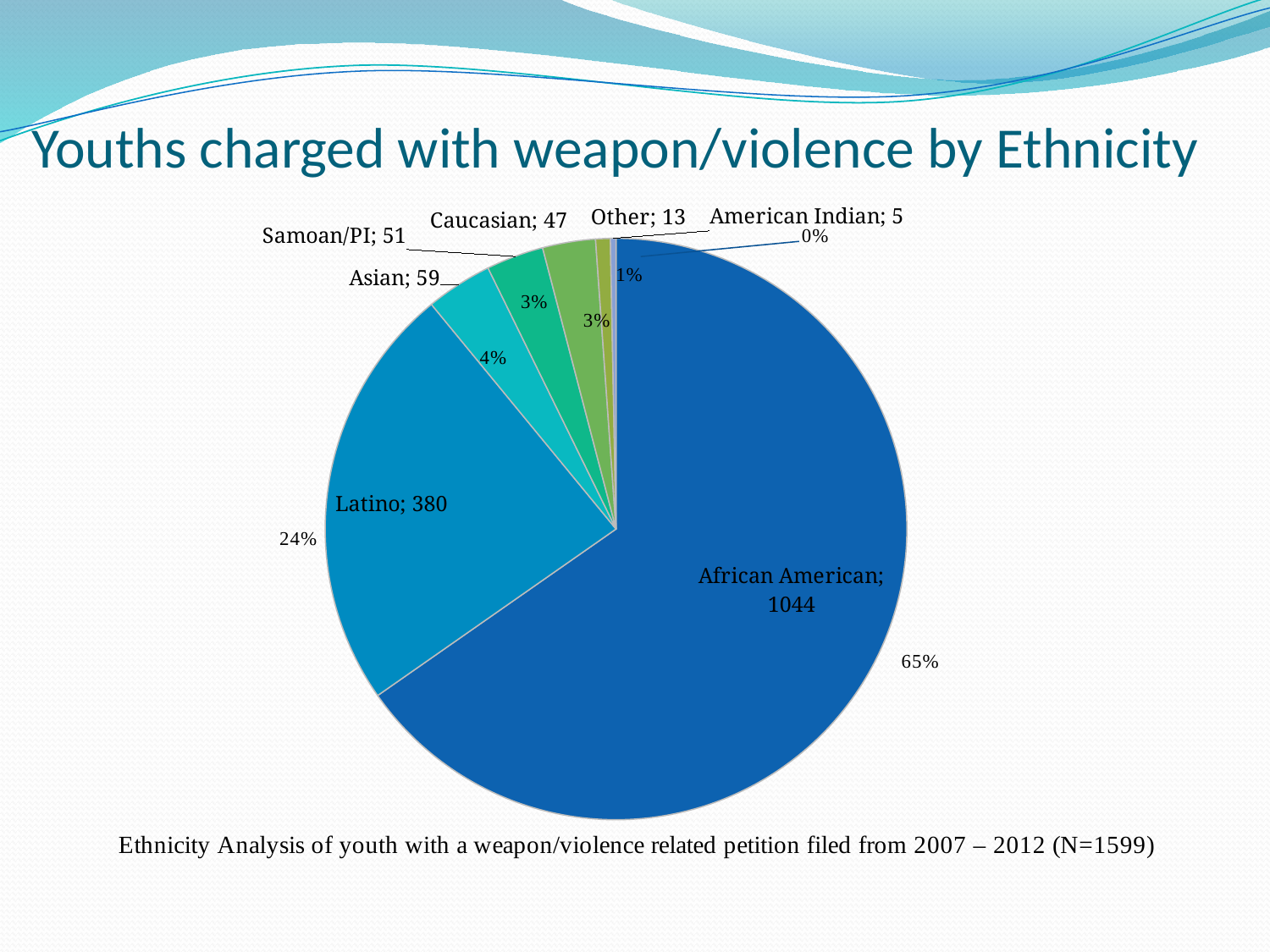
What share of the pie does Latino represent? 24% What is the value for Asian? 59 How many youths charged with weapon/violence were African American? 1044 What share of the pie does African American represent? 65% What kind of chart is shown on the slide? pie chart What is the value for American Indian? 5 Which ethnicity has the largest slice of the pie? African American Which is larger, the value for Asian or the value for Other? Asian How many ethnicity categories are shown in the pie chart? 7 What is the difference between the values for Samoan/PI and Caucasian? 4 Which ethnicity has the smallest slice of the pie? American Indian What is the value for Latino? 380